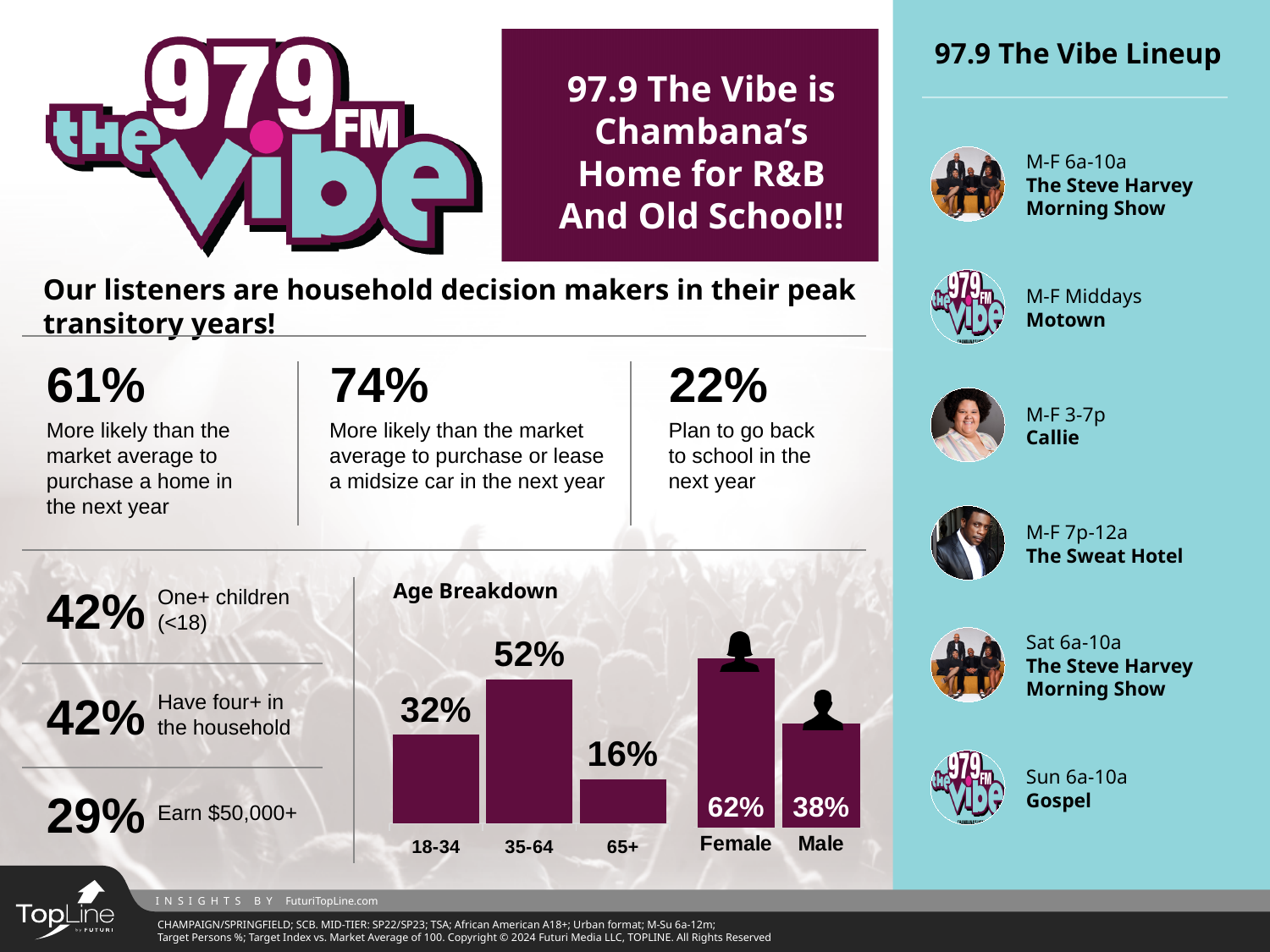
In the gender chart to the right of the Age Breakdown chart, which is larger, Female or Male? Female In the Age Breakdown chart, what is the value for the 65+ age group? 16% In the gender chart to the right of the Age Breakdown chart, what is the difference between the Female and Male values? 24% In the Age Breakdown chart, what is the difference between the 35-64 and 18-34 values? 20% How many age groups are shown in the Age Breakdown chart? 3 What kind of chart is the Age Breakdown chart? bar chart In the Age Breakdown chart, which is larger, the value for 18-34 or the value for 65+? 18-34 In the gender chart to the right of the Age Breakdown chart, what is the value for Female? 62% In the Age Breakdown chart, which age group has the highest value? 35-64 In the Age Breakdown chart, what is the value for the 35-64 age group? 52% In the Age Breakdown chart, what is the value for the 18-34 age group? 32% In the Age Breakdown chart, which age group has the lowest value? 65+